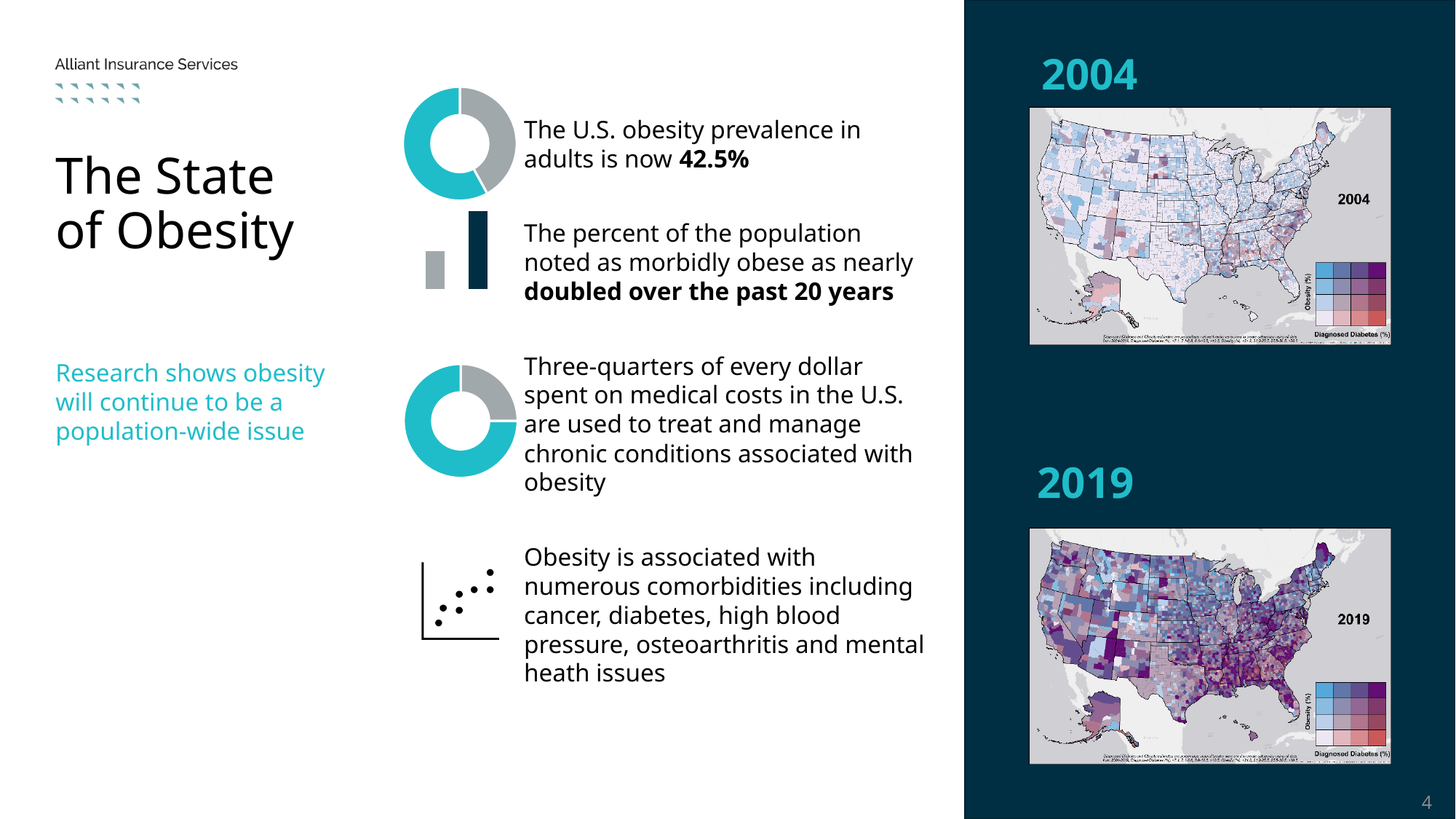
In the two-bar icon next to the morbid obesity statement, which bar is taller, the grey one or the dark blue one? the dark blue one What year is the bottom map on the right side of the slide labeled? 2019 What share does the teal segment of the lower donut chart represent, according to the text beside it? Three-quarters What year is the top map on the right side of the slide labeled? 2004 What kind of chart is the icon next to the statement about U.S. adult obesity prevalence? donut chart What share does the teal segment of the top donut chart represent, according to the text beside it? 42.5% How many donut charts appear on the slide? 2